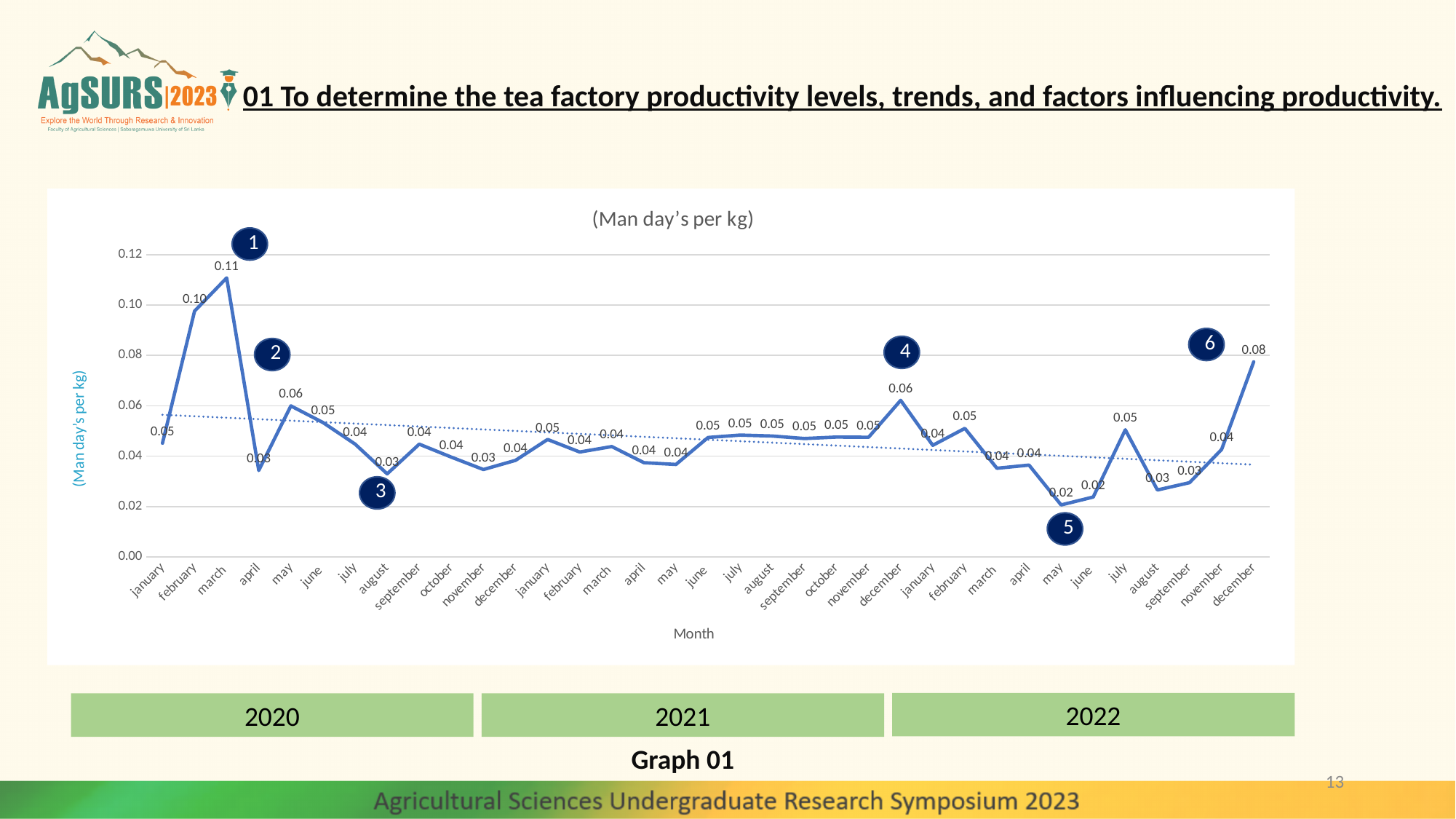
What is the title of the x axis? Month Which month has the highest value on the chart? March 2020 Which is larger, the value for March 2020 or the value for December 2022? March 2020 What is the difference between the values for December 2022 and December 2021? 0.02 What is the difference between the values for March 2020 and February 2020? 0.01 How many monthly data points are plotted on the chart? 35 What is the value for December 2022? 0.08 What kind of chart is shown on the slide? line chart What is the value for March 2020? 0.11 What is the value for December 2021? 0.06 What is the lowest value plotted on the chart? 0.02 Does the dotted trend line rise or fall from left to right? fall